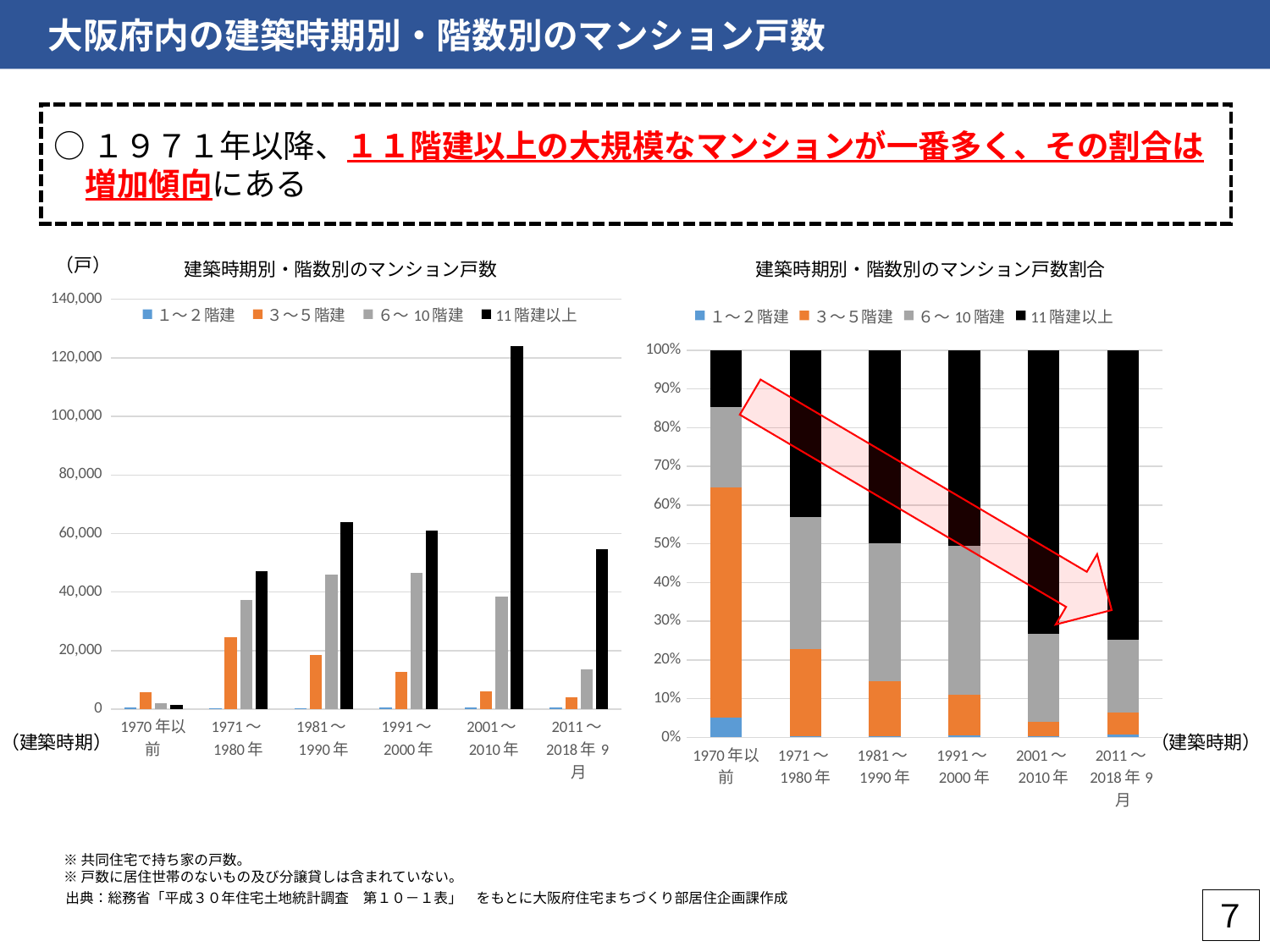
In the right chart (建築時期別・階数別のマンション戸数割合), which floor category has the largest share in 1970年以前? 3〜5階建 How many series does the legend of the left chart (建築時期別・階数別のマンション戸数) list? 4 In the right chart (建築時期別・階数別のマンション戸数割合), does the share of 11階建以上 rise or fall from 1970年以前 to 2011〜2018年9月? rise In the left chart (建築時期別・階数別のマンション戸数), is the value for 11階建以上 in 2001〜2010年 greater or less than 120,000? greater In the left chart (建築時期別・階数別のマンション戸数), is the value for 11階建以上 in 1971〜1980年 greater or less than 60,000? less In the left chart (建築時期別・階数別のマンション戸数), is the value for 11階建以上 in 1981〜1990年 greater or less than 60,000? greater In the left chart (建築時期別・階数別のマンション戸数), which is larger: 11階建以上 in 2001〜2010年 or 11階建以上 in 1981〜1990年? 2001〜2010年 What kind of chart is the left chart titled 建築時期別・階数別のマンション戸数? bar chart How many building-period categories are shown on the x axis of the right chart (建築時期別・階数別のマンション戸数割合)? 6 In the left chart (建築時期別・階数別のマンション戸数), which building period has the highest value for 11階建以上? 2001〜2010年 In the left chart (建築時期別・階数別のマンション戸数), which building period has the highest value for 3〜5階建? 1971〜1980年